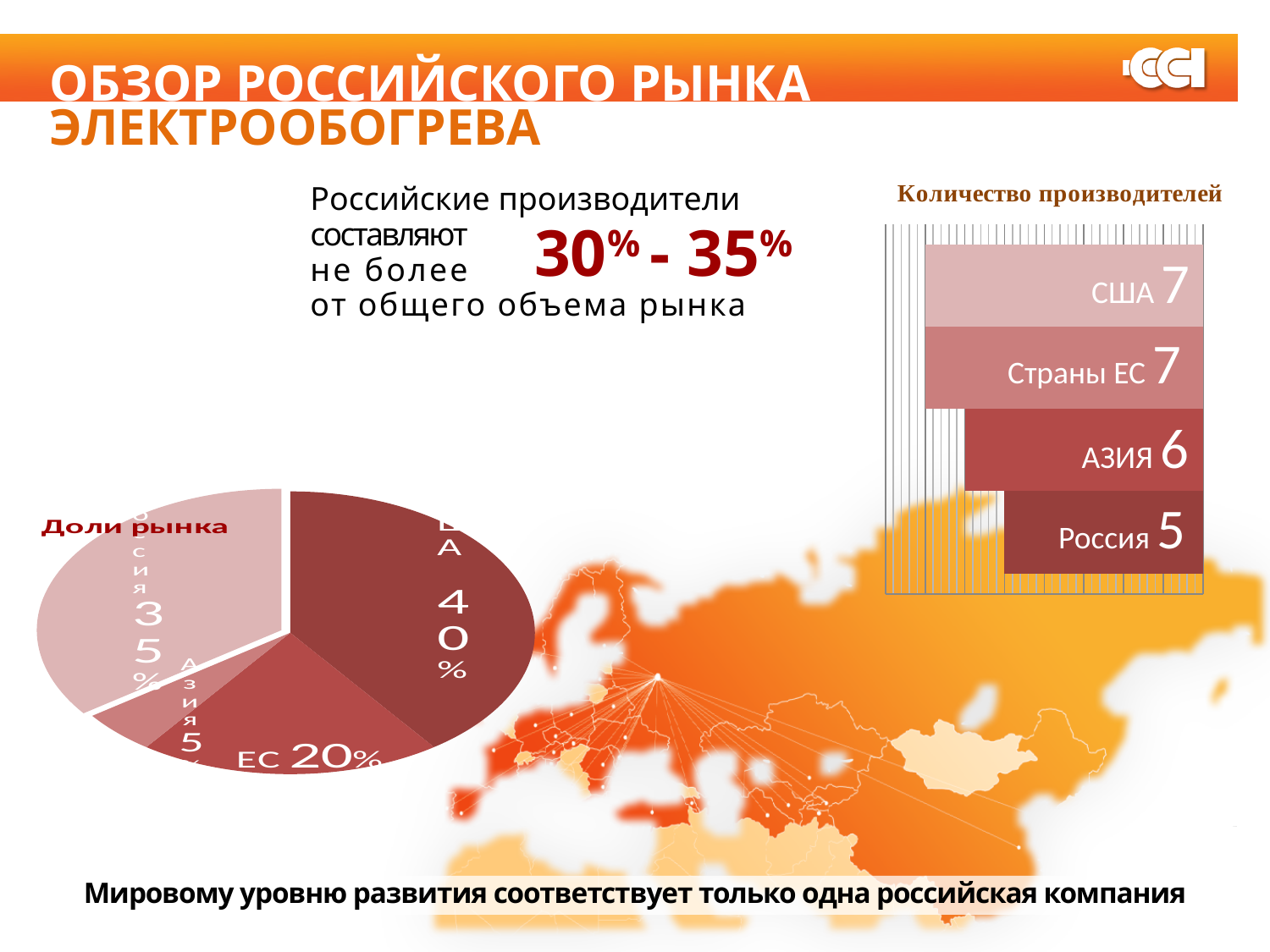
On the chart titled "Количество производителей", how many categories are shown? 4 What kind of chart is the one titled "Количество производителей"? Bar chart On the chart titled "Количество производителей", which category has the lowest value? Россия On the chart titled "Количество производителей", what is the value for АЗИЯ? 6 On the chart titled "Количество производителей", which is larger, the value for АЗИЯ or the value for Россия? АЗИЯ What kind of chart is the one titled "Доли рынка"? Pie chart On the chart titled "Количество производителей", what is the value for США? 7 On the chart titled "Доли рынка", which category has the largest share? США On the chart titled "Количество производителей", what is the value for Россия? 5 On the chart titled "Количество производителей", what is the difference between the values for США and Россия? 2 On the chart titled "Доли рынка", what share does Азия have? 5% On the chart titled "Доли рынка", what share does ЕС have? 20%